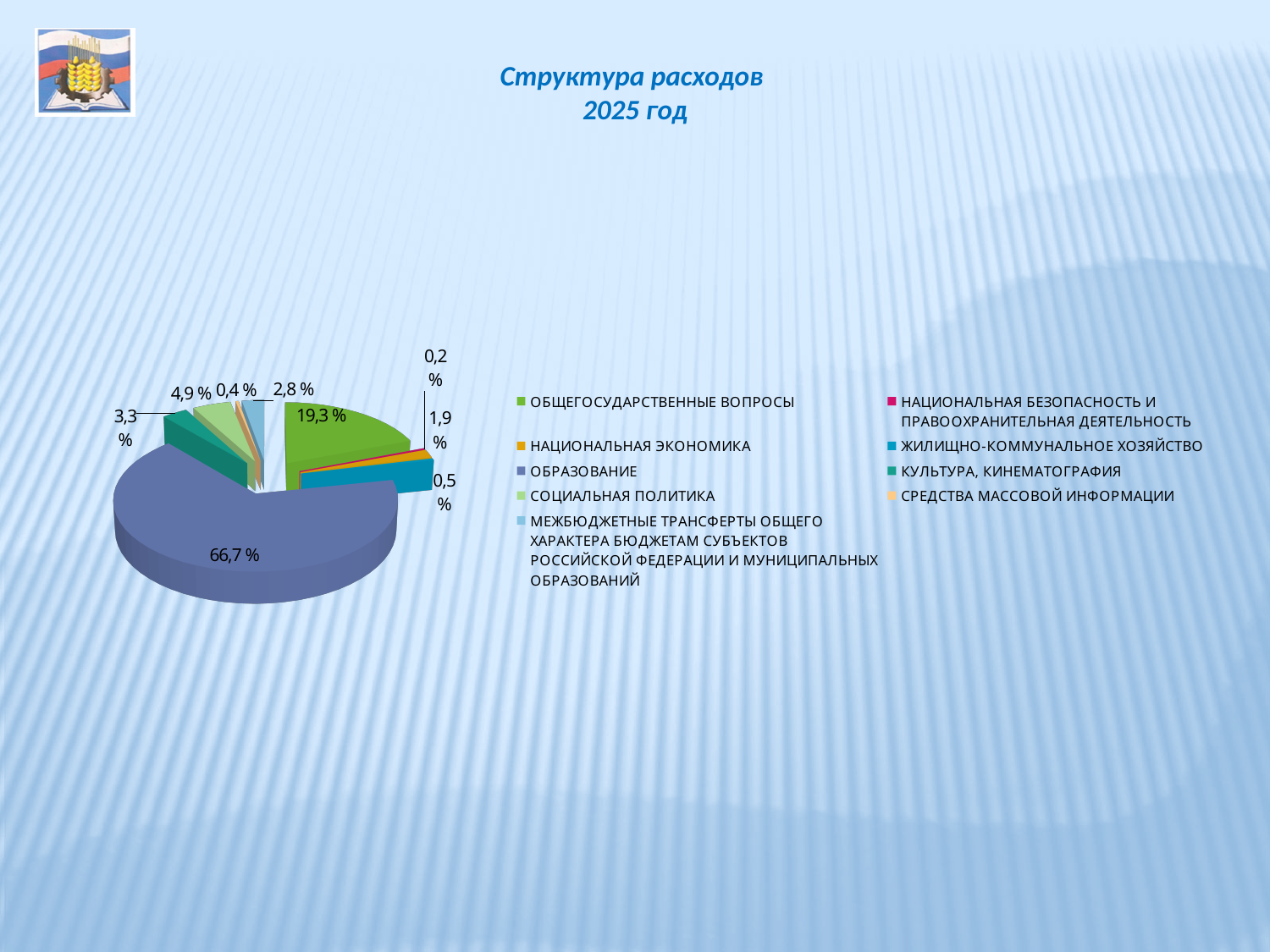
What share is shown for КУЛЬТУРА, КИНЕМАТОГРАФИЯ? 3,3 % Which category has the smallest share of expenditures? НАЦИОНАЛЬНАЯ БЕЗОПАСНОСТЬ И ПРАВООХРАНИТЕЛЬНАЯ ДЕЯТЕЛЬНОСТЬ What share is shown for СОЦИАЛЬНАЯ ПОЛИТИКА? 4,9 % What share is shown for НАЦИОНАЛЬНАЯ ЭКОНОМИКА? 1,9 % What share of expenditures does ОБРАЗОВАНИЕ account for? 66,7 % Which has the larger share: СОЦИАЛЬНАЯ ПОЛИТИКА or МЕЖБЮДЖЕТНЫЕ ТРАНСФЕРТЫ ОБЩЕГО ХАРАКТЕРА? СОЦИАЛЬНАЯ ПОЛИТИКА What is the difference in percentage points between ОБРАЗОВАНИЕ and ОБЩЕГОСУДАРСТВЕННЫЕ ВОПРОСЫ? 47,4 % What share of expenditures does ОБЩЕГОСУДАРСТВЕННЫЕ ВОПРОСЫ account for? 19,3 % What is the title of the chart on the slide? Структура расходов 2025 год What kind of chart is shown on the slide? Pie chart How many categories does the legend of the pie chart list? 9 Which category has the largest share of expenditures? ОБРАЗОВАНИЕ